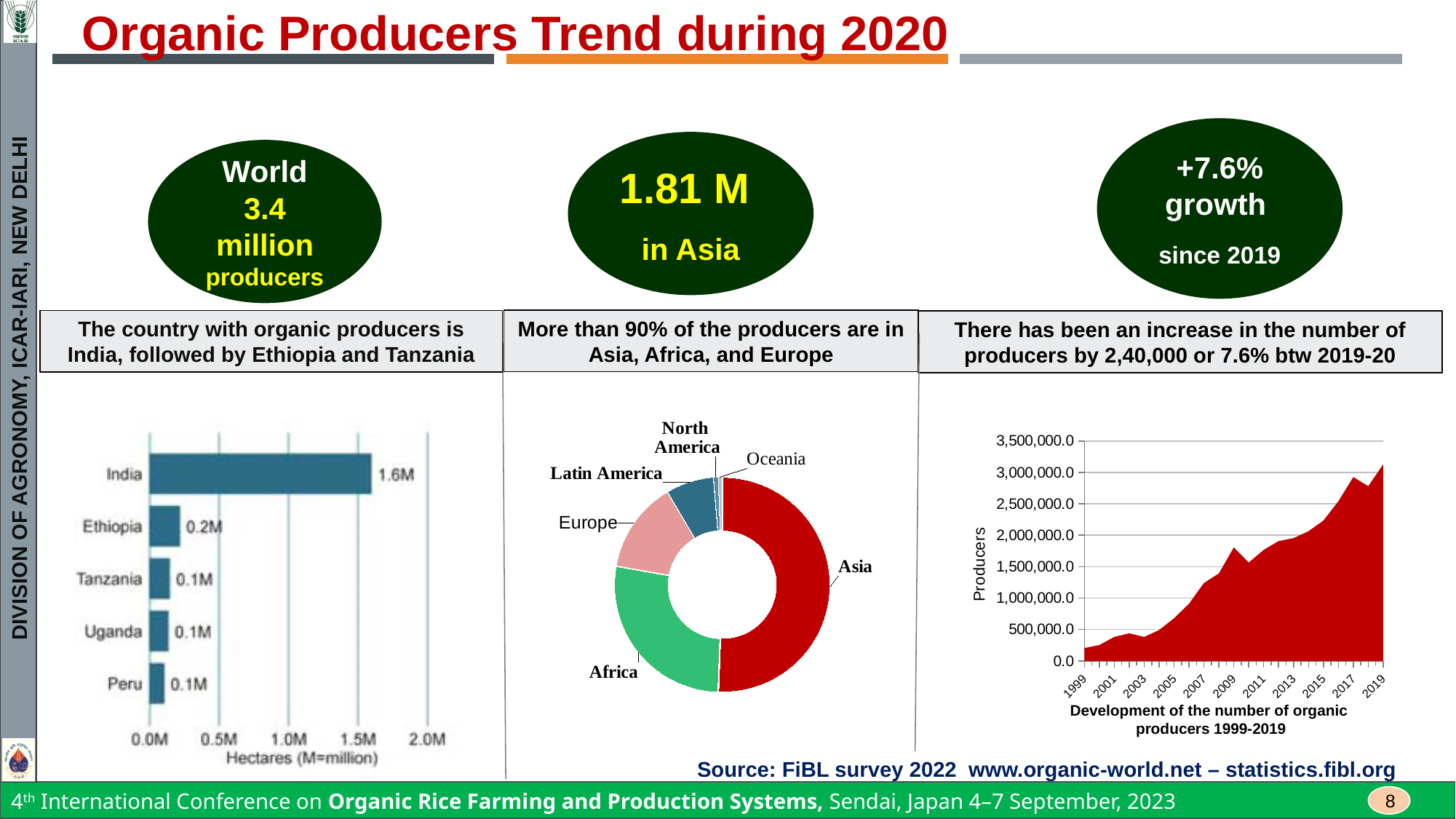
In the bar chart on the left, what is the value for Ethiopia? 0.2M In the bar chart on the left, which country has the highest value? India In the bar chart on the left, what is the value for India? 1.6M In the chart on the right titled 'Development of the number of organic producers 1999-2019', is the value for 2019 greater or less than 3,000,000.0? greater What kind of chart is the chart on the left? bar chart In the bar chart on the left, what is the difference between the values for India and Ethiopia? 1.4M In the chart on the right titled 'Development of the number of organic producers 1999-2019', what is the label of the y axis? Producers In the chart on the right titled 'Development of the number of organic producers 1999-2019', do the values generally rise or fall from 1999 to 2019? rise In the donut chart in the middle, which region has the largest slice? Asia In the bar chart on the left, which is larger, the value for India or the value for Ethiopia? India In the donut chart in the middle, how many regions are shown? 6 In the bar chart on the left, how many countries are shown? 5